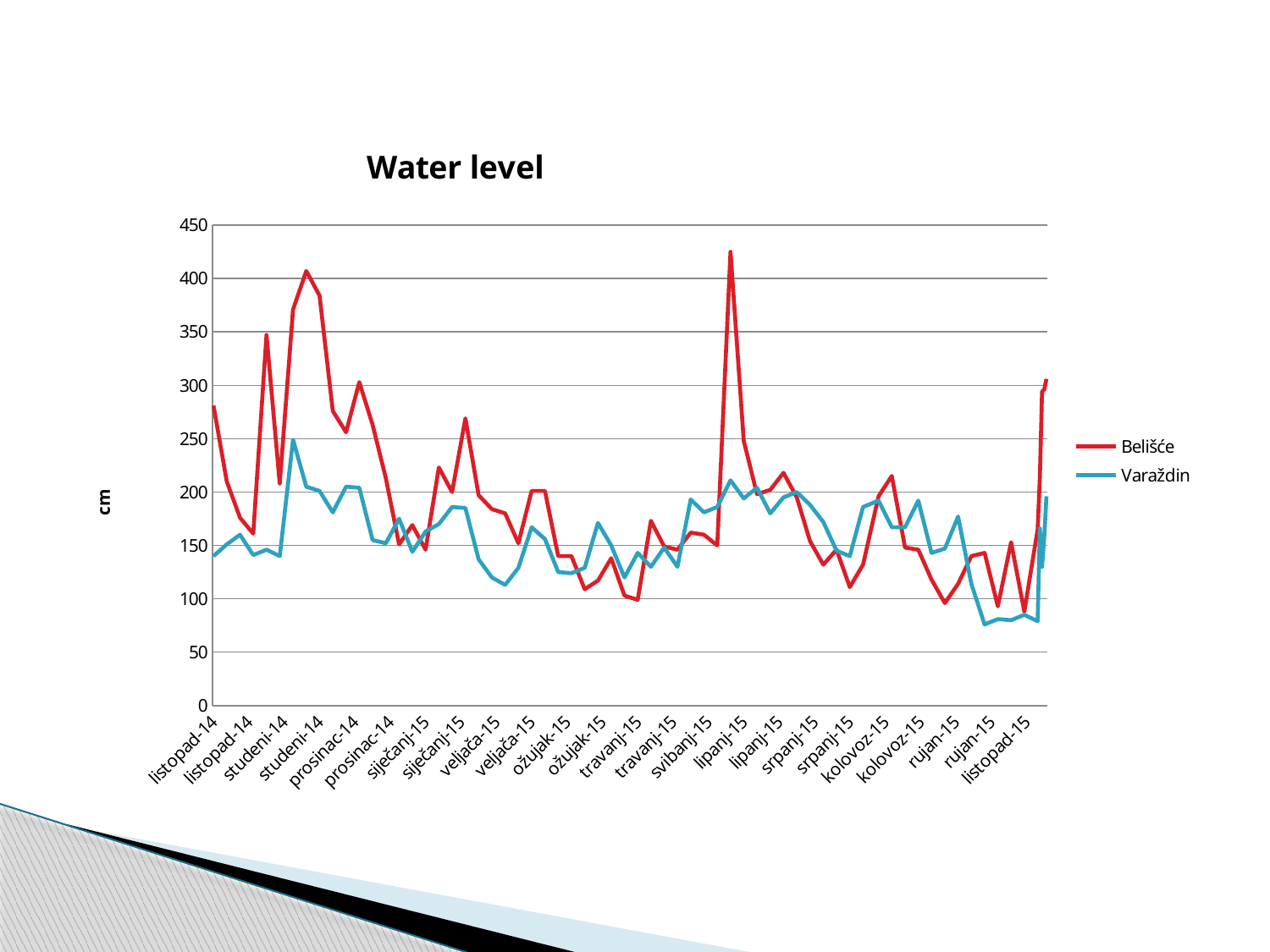
Is the Belišće value at the last point on the chart greater or less than 250? greater Is the highest value of the Varaždin series (around studeni-14) greater or less than 200? greater What kind of chart is shown on the slide? line chart What is the title of the chart? Water level How many series does the legend list? 2 Is the highest value of the Varaždin series (around studeni-14) greater or less than 300? less Which series reaches the highest value anywhere on the chart? Belišće At the first point (listopad-14), which series has the higher value, Belišće or Varaždin? Belišće What unit is shown on the vertical axis label? cm